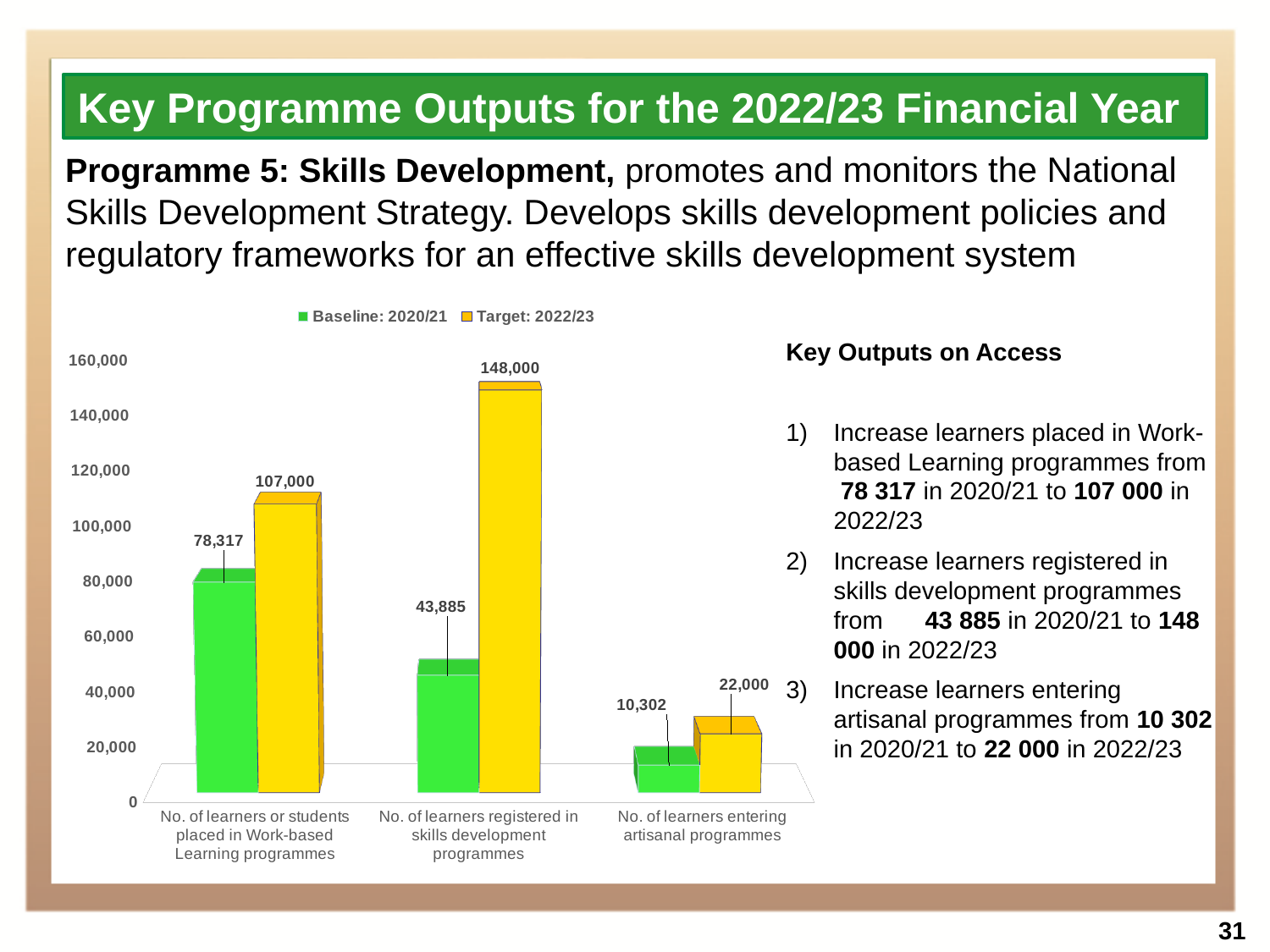
How many series does the chart legend list? 2 What is the Baseline: 2020/21 value for No. of learners registered in skills development programmes? 43,885 What is the difference between the Target: 2022/23 and Baseline: 2020/21 values for No. of learners or students placed in Work-based Learning programmes? 28,683 What is the Target: 2022/23 value for No. of learners registered in skills development programmes? 148,000 How many categories are shown on the x axis of the chart? 3 What is the Target: 2022/23 value for No. of learners entering artisanal programmes? 22,000 Which is larger: the Baseline: 2020/21 value for No. of learners or students placed in Work-based Learning programmes or the Baseline: 2020/21 value for No. of learners registered in skills development programmes? No. of learners or students placed in Work-based Learning programmes Which category has the lowest Baseline: 2020/21 value? No. of learners entering artisanal programmes Is the Target: 2022/23 value for No. of learners or students placed in Work-based Learning programmes greater or less than 100,000? greater Which category has the highest Target: 2022/23 value? No. of learners registered in skills development programmes What kind of chart is shown on the slide? Bar chart What is the Baseline: 2020/21 value for No. of learners or students placed in Work-based Learning programmes? 78,317